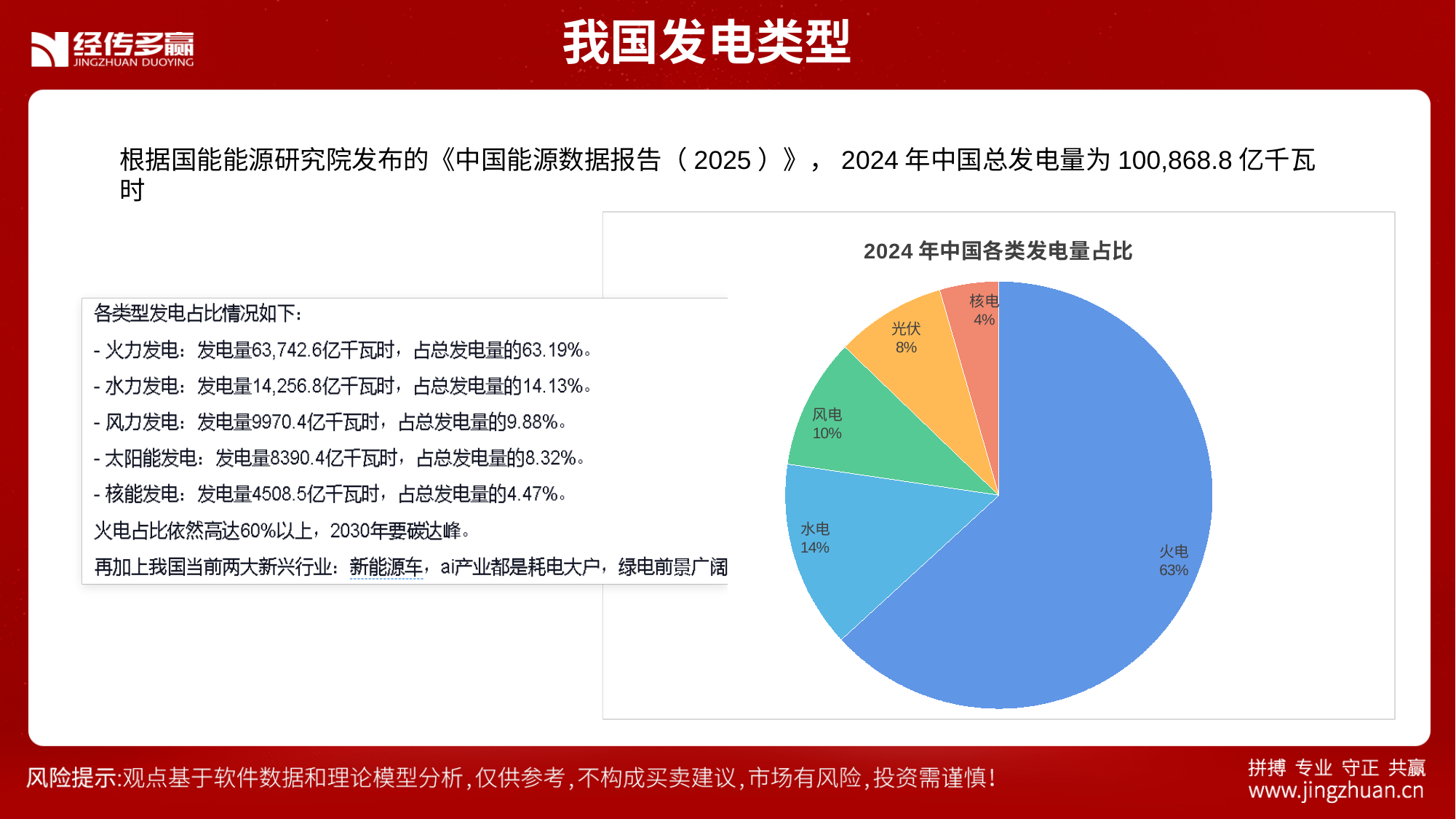
Which category has the largest slice of the pie? 火电 Which category has the smallest slice of the pie? 核电 What is the title of the pie chart? 2024 年中国各类发电量占比 What type of chart is shown on the slide? Pie chart Which slice is larger, 风电 or 光伏? 风电 How many slices does the pie chart have? 5 What share of the pie does 核电 account for? 4% What share of the pie does 火电 account for? 63% What is the difference in percentage points between the 火电 slice and the 水电 slice? 49 What share of the pie does 光伏 account for? 8%